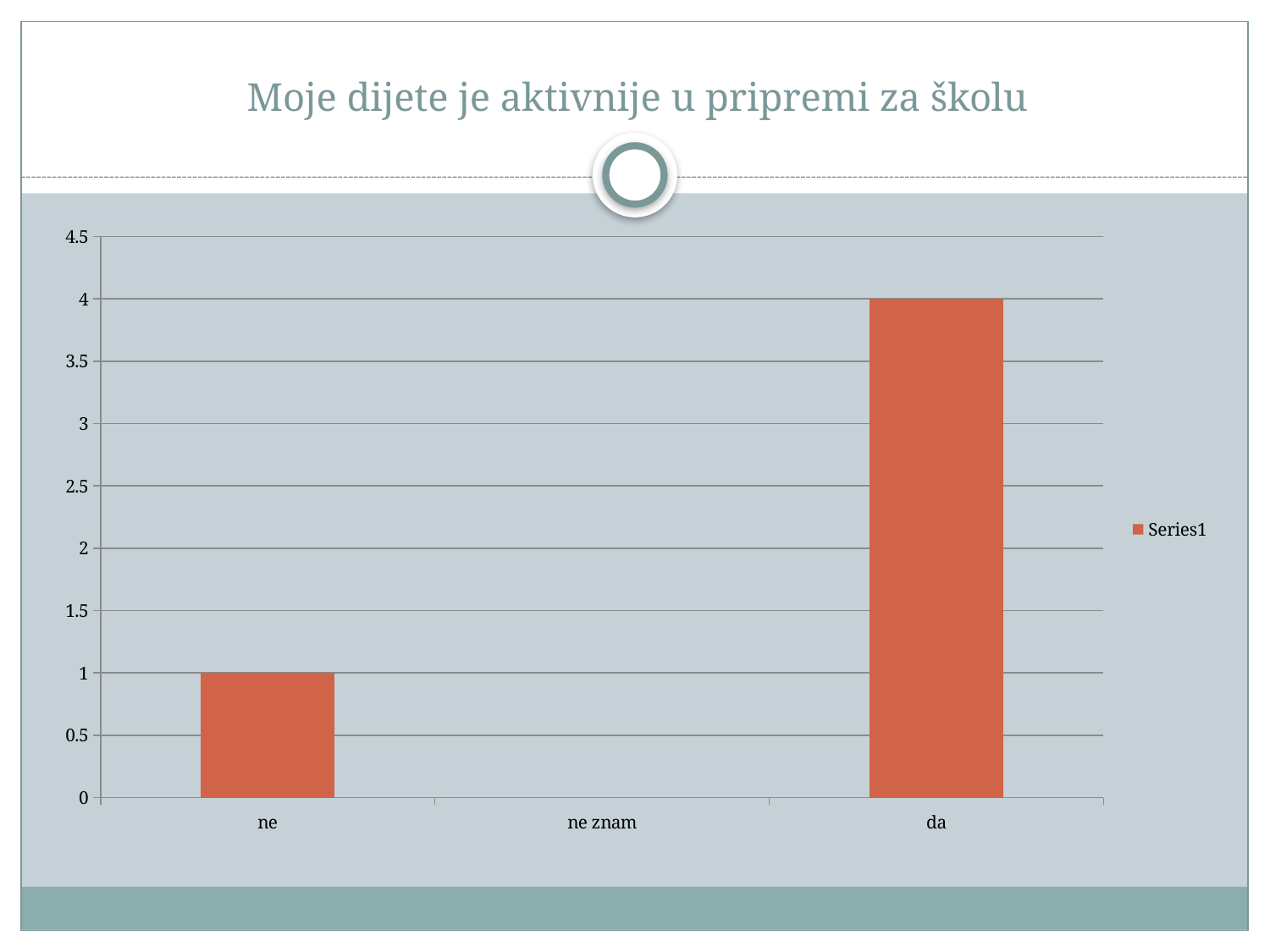
Is the value for "da" greater or less than 3? greater What is the value for "ne znam"? 0 What is the difference between the values for "da" and "ne"? 3 Which category has the highest value? da What kind of chart is shown on the slide? bar chart What is the value for "da"? 4 Which is larger, the value for "ne" or the value for "da"? da What is the value for "ne"? 1 How many series does the legend list? 1 Which category has the lowest value? ne znam Is the value for "ne" greater or less than 2? less How many categories are shown on the x axis? 3